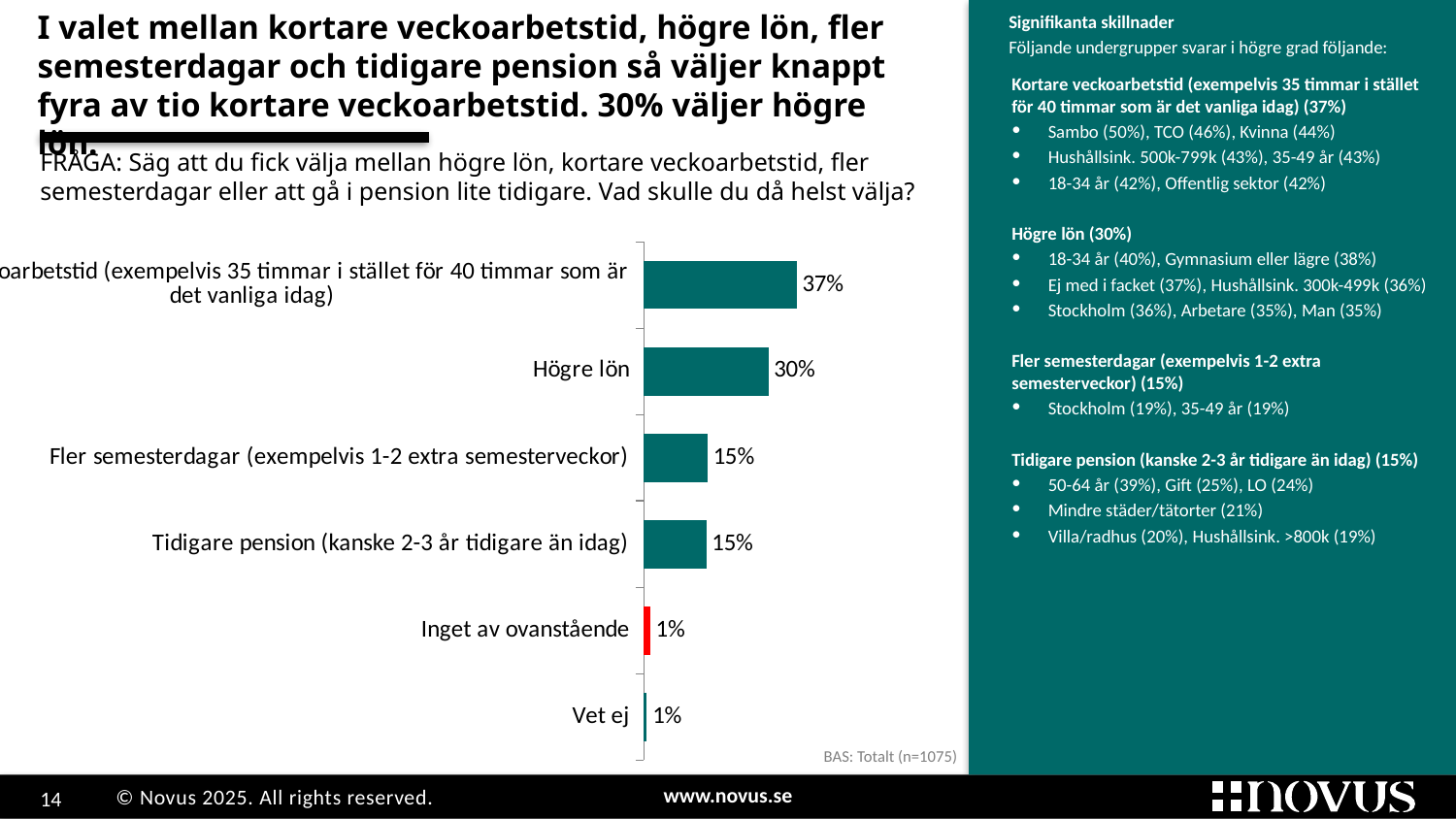
What is the value for Högre lön? 30% Which categories have the lowest value? Inget av ovanstående and Vet ej What is the value for Vet ej? 1% What is the value of the top bar, the category about 35 timmar i stället för 40 timmar som är det vanliga idag? 37% What kind of chart is shown on the slide? Bar chart Which category has the highest value? Kortare veckoarbetstid (exempelvis 35 timmar i stället för 40 timmar som är det vanliga idag) How many categories are shown in the chart? 6 What is the value for Fler semesterdagar (exempelvis 1-2 extra semesterveckor)? 15% Which is larger, Högre lön or Fler semesterdagar? Högre lön What is the difference between the top bar (37%) and Högre lön? 7 percentage points What is the value for Inget av ovanstående? 1% What is the value for Tidigare pension (kanske 2-3 år tidigare än idag)? 15%